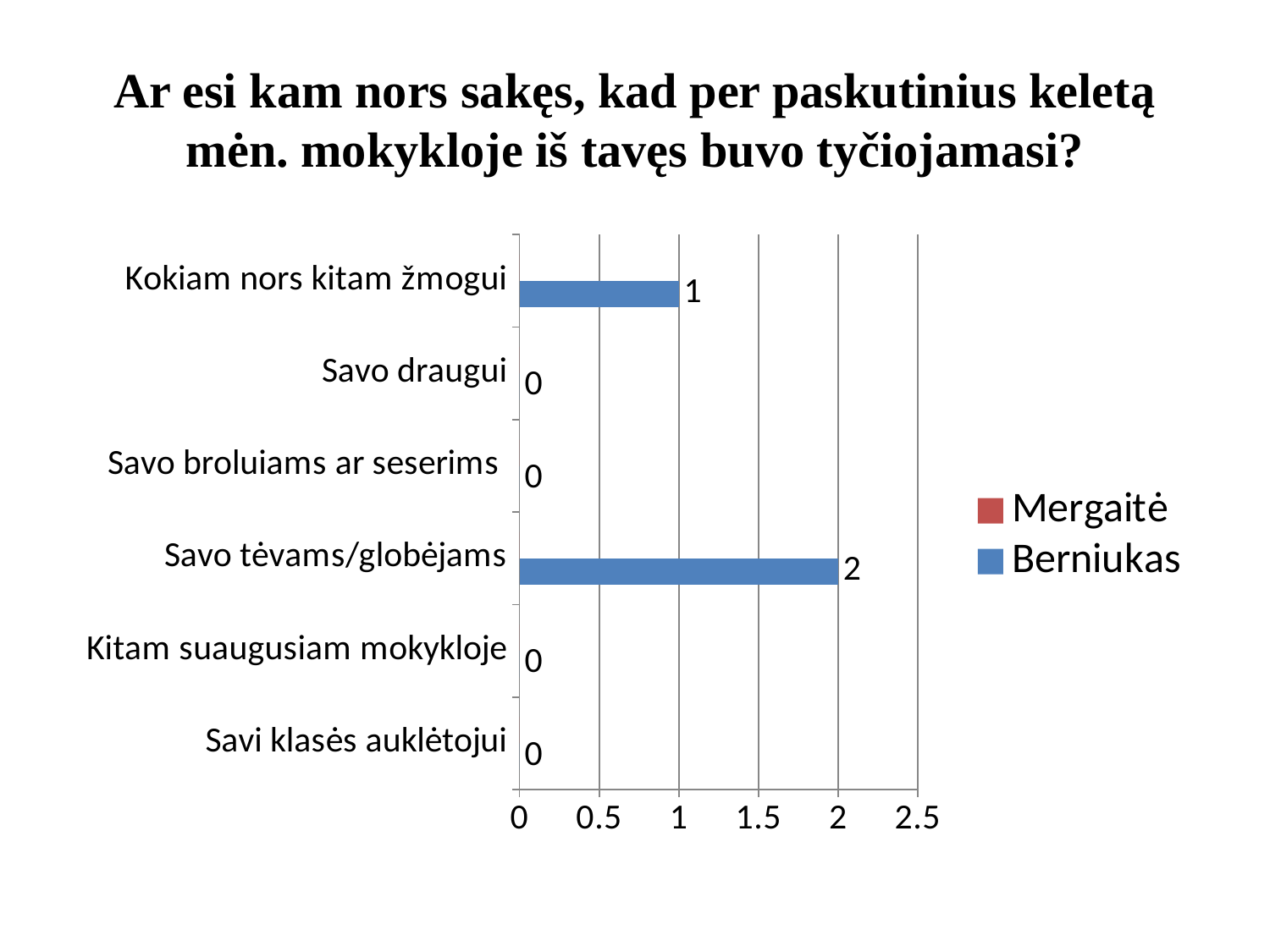
What is the value for Berniukas for "Savi klasės auklėtojui"? 0 What is the difference between the Berniukas values for "Savo tėvams/globėjams" and "Kokiam nors kitam žmogui"? 1 What is the value for Berniukas for "Savo draugui"? 0 What kind of chart is shown on the slide? Bar chart Which category has the highest Berniukas value? Savo tėvams/globėjams What is the value for Berniukas for "Kokiam nors kitam žmogui"? 1 What is the value for Berniukas for "Savo tėvams/globėjams"? 2 Which is larger for Berniukas: "Savo tėvams/globėjams" or "Kokiam nors kitam žmogui"? Savo tėvams/globėjams What is the maximum value shown on the horizontal axis? 2.5 How many categories are shown on the chart? 6 How many series does the legend list? 2 What are the two series named in the legend? Mergaitė and Berniukas